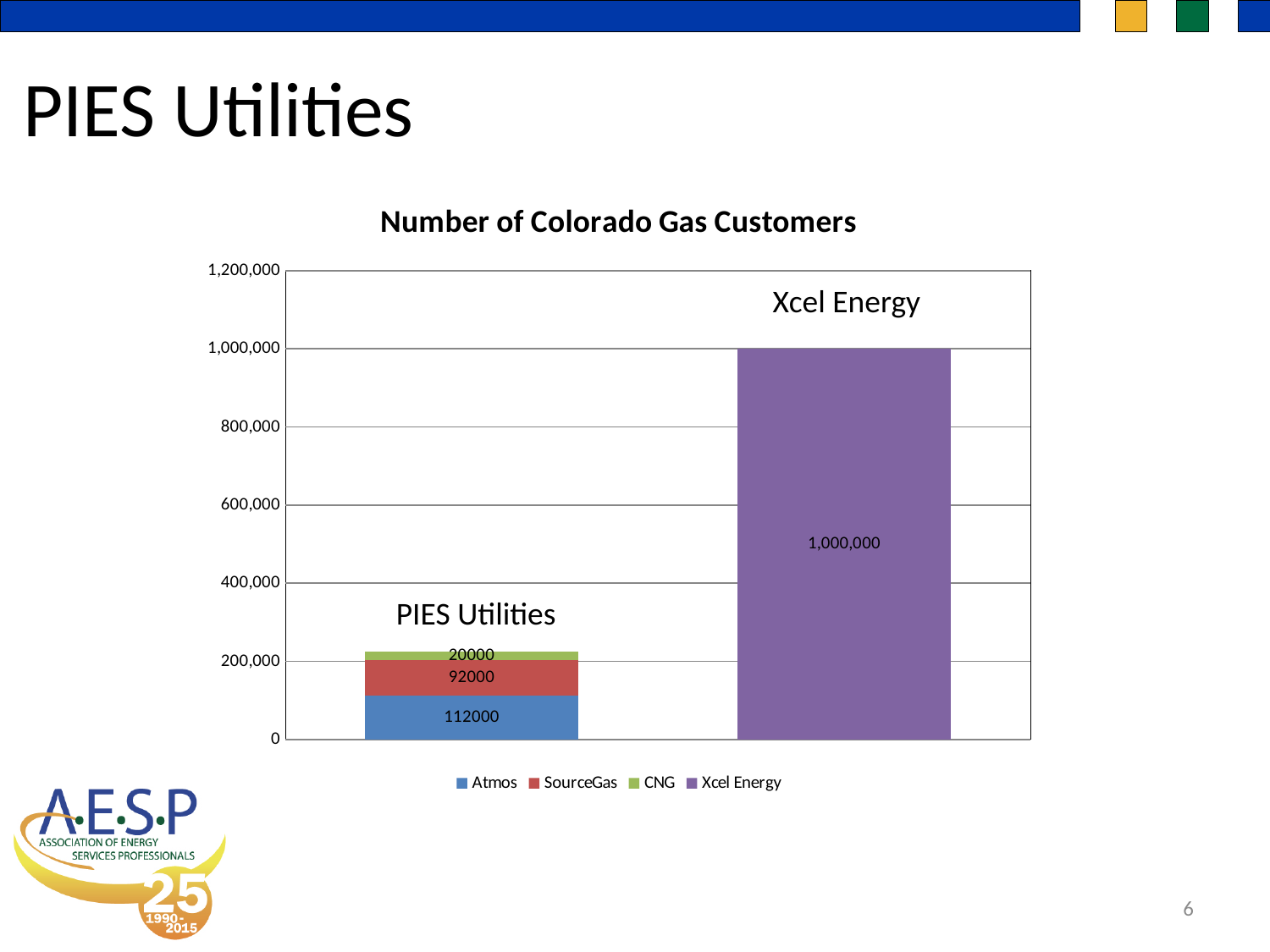
What is the value for CNG in the PIES Utilities bar? 20000 How many series does the legend list? 4 What is the difference between the Atmos value and the SourceGas value? 20000 What kind of chart is shown on the slide? Stacked bar chart What is the total of the PIES Utilities stacked bar? 224000 What is the value shown for Xcel Energy? 1,000,000 Which segment of the PIES Utilities bar is the smallest? CNG What is the title of the chart? Number of Colorado Gas Customers Which of the two bars, PIES Utilities or Xcel Energy, is taller? Xcel Energy Is the total of the PIES Utilities bar greater or less than 400,000? less What is the value for Atmos in the PIES Utilities bar? 112000 What is the value for SourceGas in the PIES Utilities bar? 92000